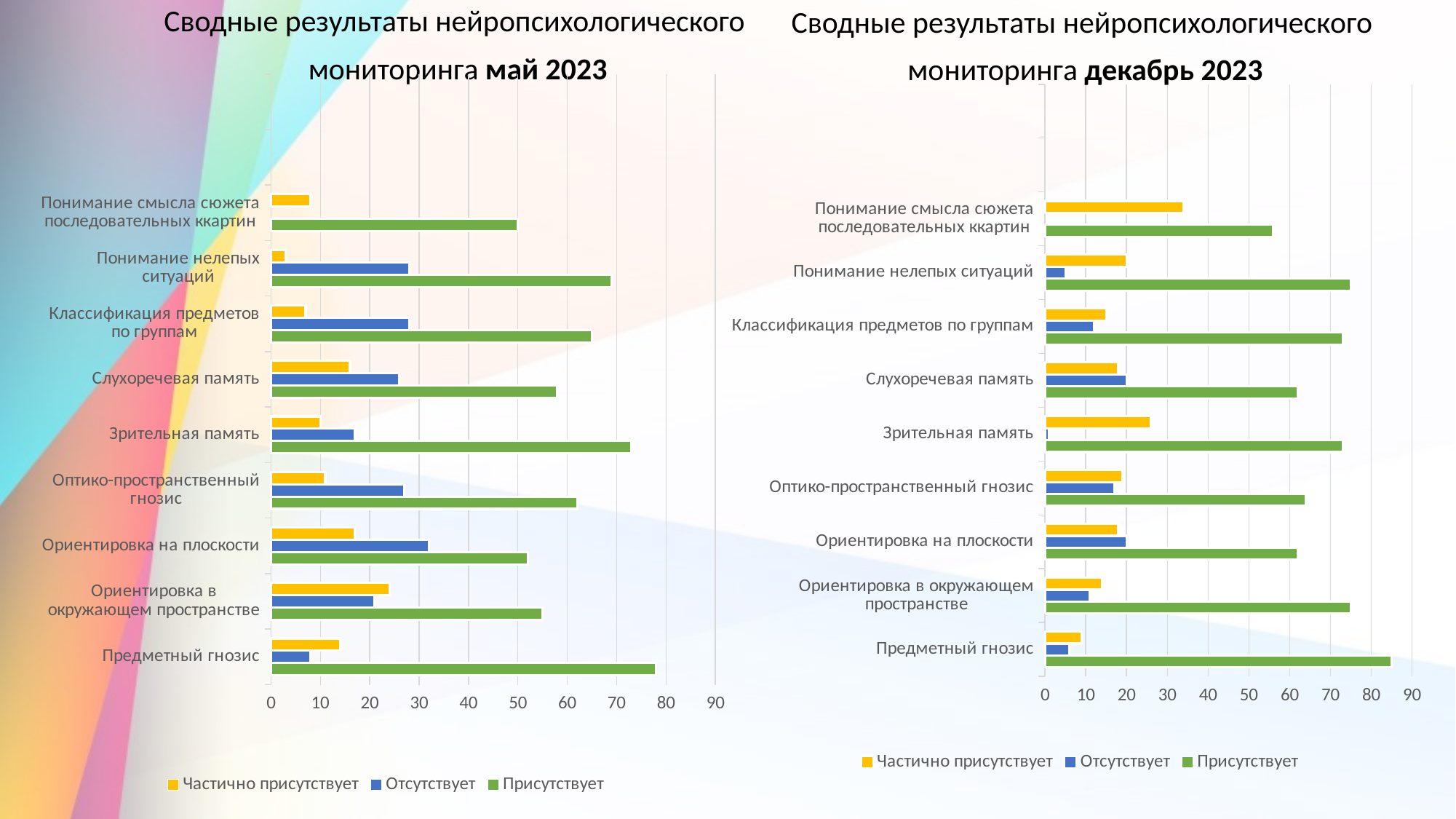
In the 'декабрь 2023' chart, which category has the highest 'Присутствует' value? Предметный гнозис Which colour represents the 'Присутствует' series in both charts? green How many series does the legend of the 'май 2023' chart list? 3 In the 'май 2023' chart, which is larger for Ориентировка на плоскости: 'Отсутствует' or 'Частично присутствует'? Отсутствует How many categories are shown on the 'декабрь 2023' chart on the right? 9 In the 'май 2023' chart, is the 'Присутствует' value for Предметный гнозис greater or less than 70? greater In the 'май 2023' chart, which category has the highest 'Присутствует' value? Предметный гнозис In the 'декабрь 2023' chart, is the 'Частично присутствует' value for Понимание смысла сюжета последовательных ккартин greater or less than 30? greater In the 'декабрь 2023' chart, is the 'Присутствует' value for Предметный гнозис greater or less than 80? greater In the 'декабрь 2023' chart, which category has the highest 'Частично присутствует' value? Понимание смысла сюжета последовательных ккартин What type of chart is the 'май 2023' chart on the left? bar chart In the 'май 2023' chart, which category has the lowest 'Присутствует' value? Понимание смысла сюжета последовательных ккартин